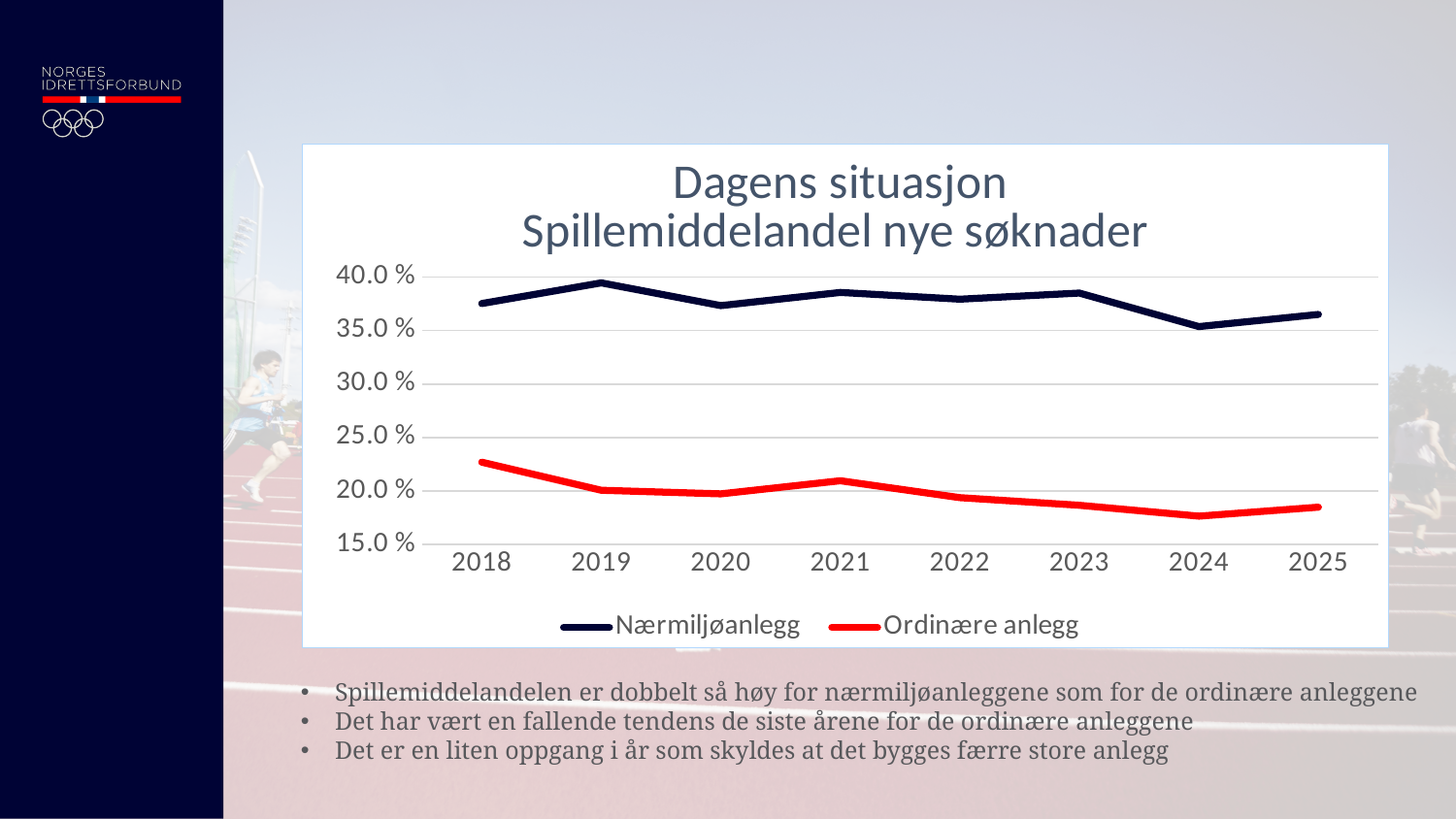
What kind of chart is shown on the slide? Line chart Is the value for Ordinære anlegg in 2024 greater or less than 20.0 %? less What is the title of the chart? Dagens situasjon Spillemiddelandel nye søknader Which series is drawn in red? Ordinære anlegg In which year is the value for Nærmiljøanlegg lowest? 2024 How many years are shown on the x axis? 8 How many series does the legend list? 2 In which year is the value for Ordinære anlegg lowest? 2024 Is the value for Ordinære anlegg in 2018 greater or less than 20.0 %? greater In which year is the value for Nærmiljøanlegg highest? 2019 Which series has the larger value in 2018, Nærmiljøanlegg or Ordinære anlegg? Nærmiljøanlegg In which year is the value for Ordinære anlegg highest? 2018